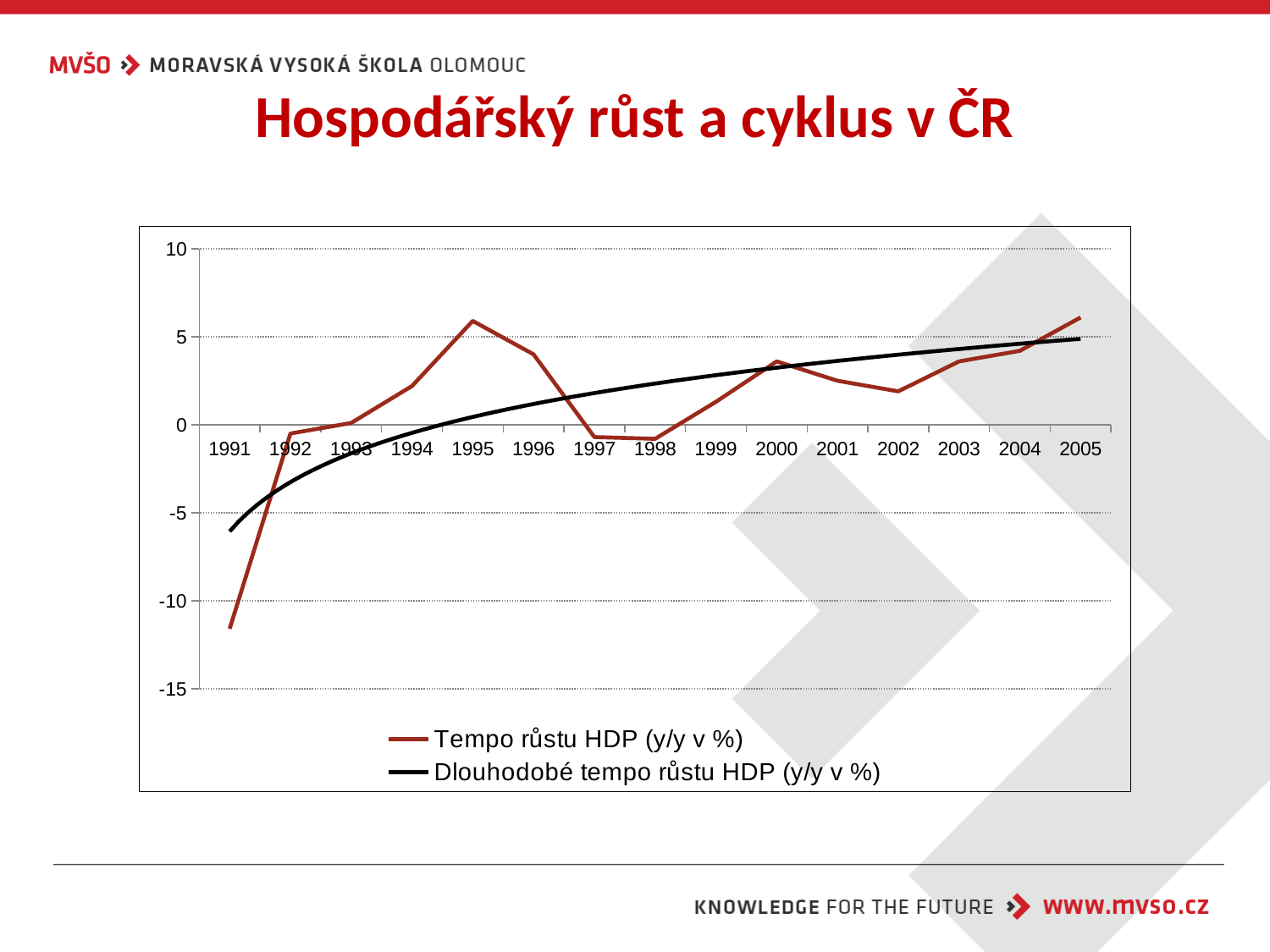
Is the value for Tempo růstu HDP (y/y v %) in 1997 greater or less than 0? less Does the Dlouhodobé tempo růstu HDP (y/y v %) line rise or fall from 1991 to 2005? rise What kind of chart is shown on the slide? line chart Is the value for Tempo růstu HDP (y/y v %) in 1995 greater or less than 5? greater How many years are plotted along the x axis? 15 What is the title of the slide containing the chart? Hospodářský růst a cyklus v ČR Which year has the lowest value for Tempo růstu HDP (y/y v %)? 1991 Is the value for Tempo růstu HDP (y/y v %) in 1991 greater or less than -10? less How many series does the legend list? 2 Which is larger for Tempo růstu HDP (y/y v %): the value in 2000 or in 2002? 2000 Which is larger for Tempo růstu HDP (y/y v %): the value in 1995 or in 1996? 1995